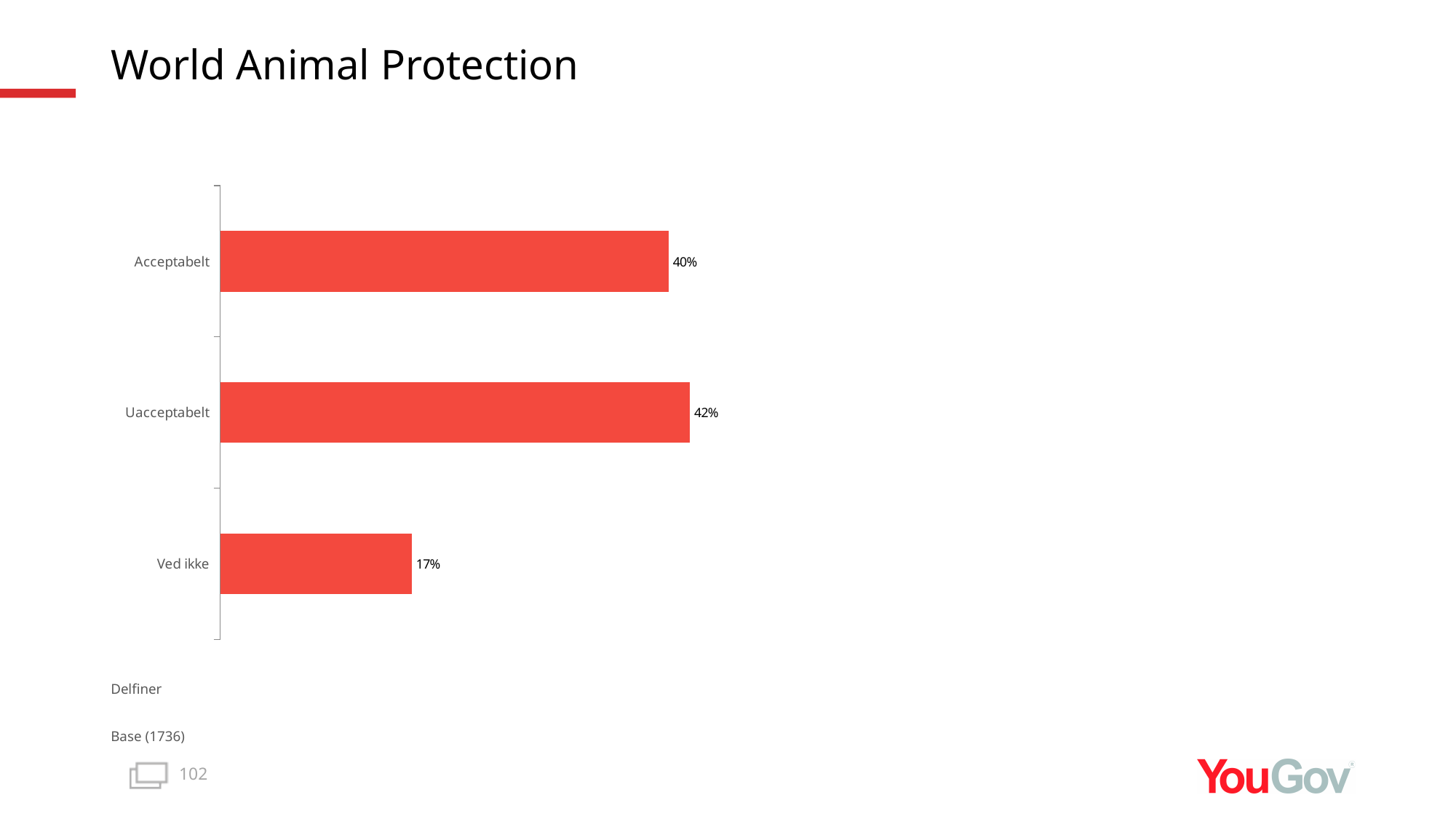
What is the difference between Uacceptabelt and Acceptabelt? 2% Which is larger, Acceptabelt or Ved ikke? Acceptabelt What kind of chart is shown on the slide? bar chart Which category has the lowest value? Ved ikke What is the value for Ved ikke? 17% How many categories are shown in the chart? 3 What is the difference between Acceptabelt and Ved ikke? 23% What is the value for Acceptabelt? 40% Which category has the highest value? Uacceptabelt What is the value for Uacceptabelt? 42% What is the title of the slide? World Animal Protection What base size is stated below the chart? 1736